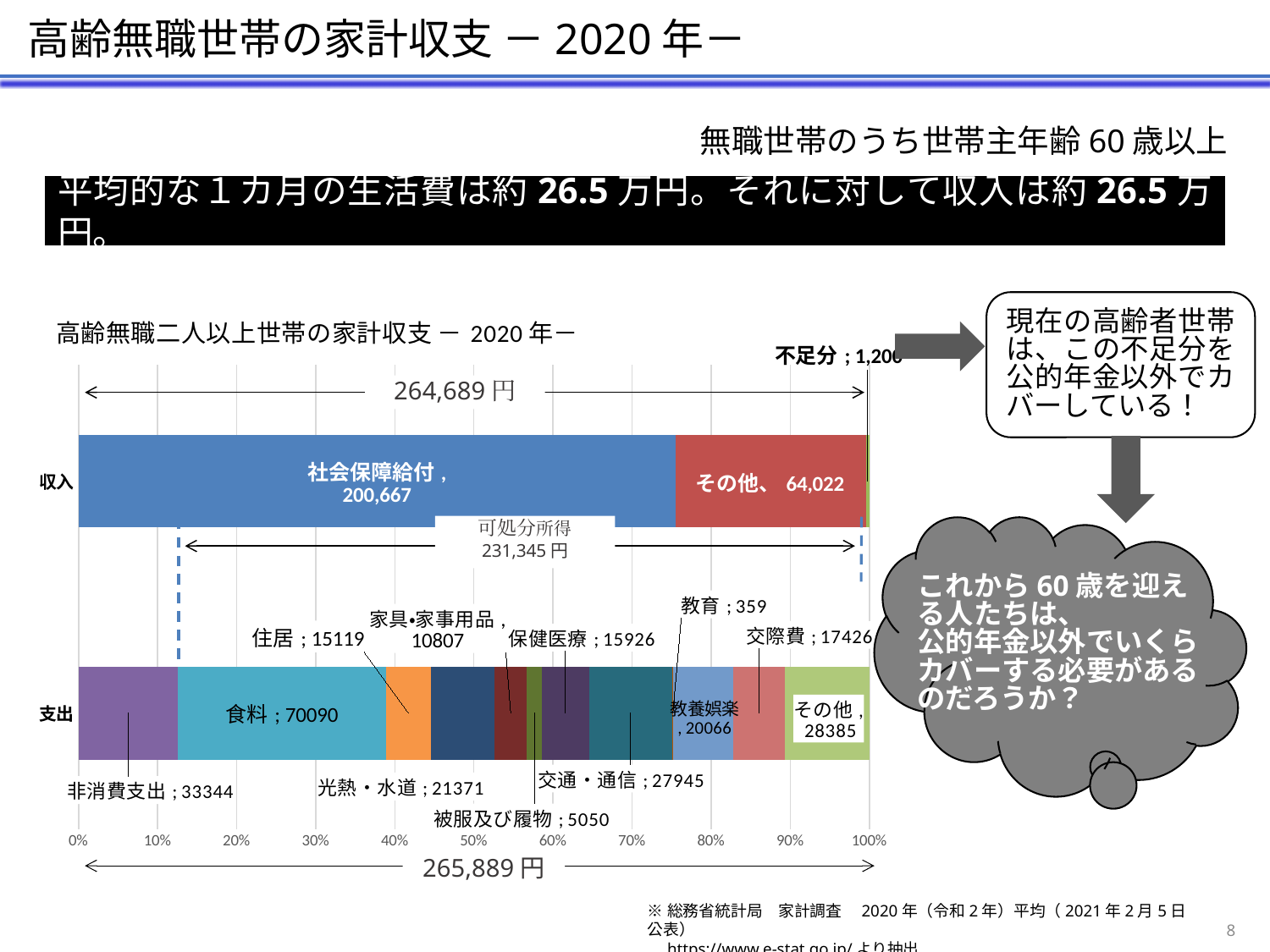
What is the value of 食料 in the 支出 bar? 70090 What is the value of 不足分 shown on the chart? 1,200 What is the value labelled 教育 in the 支出 bar? 359 What is the total of the 収入 bar as printed above the chart? 264,689円 What kind of chart is shown on the slide? Stacked bar chart What is the value of 社会保障給付 in the 収入 bar? 200,667 Which is larger in the 支出 bar, 交通・通信 or 光熱・水道? 交通・通信 What is the total of the 支出 bar as printed below the chart? 265,889円 Which expenditure item in the 支出 bar has the largest value? 食料 How many expenditure categories are labelled in the 支出 bar? 12 What is the difference between 社会保障給付 (200,667) and その他 (64,022) in the 収入 bar? 136,645 Which expenditure item in the 支出 bar has the smallest value? 教育